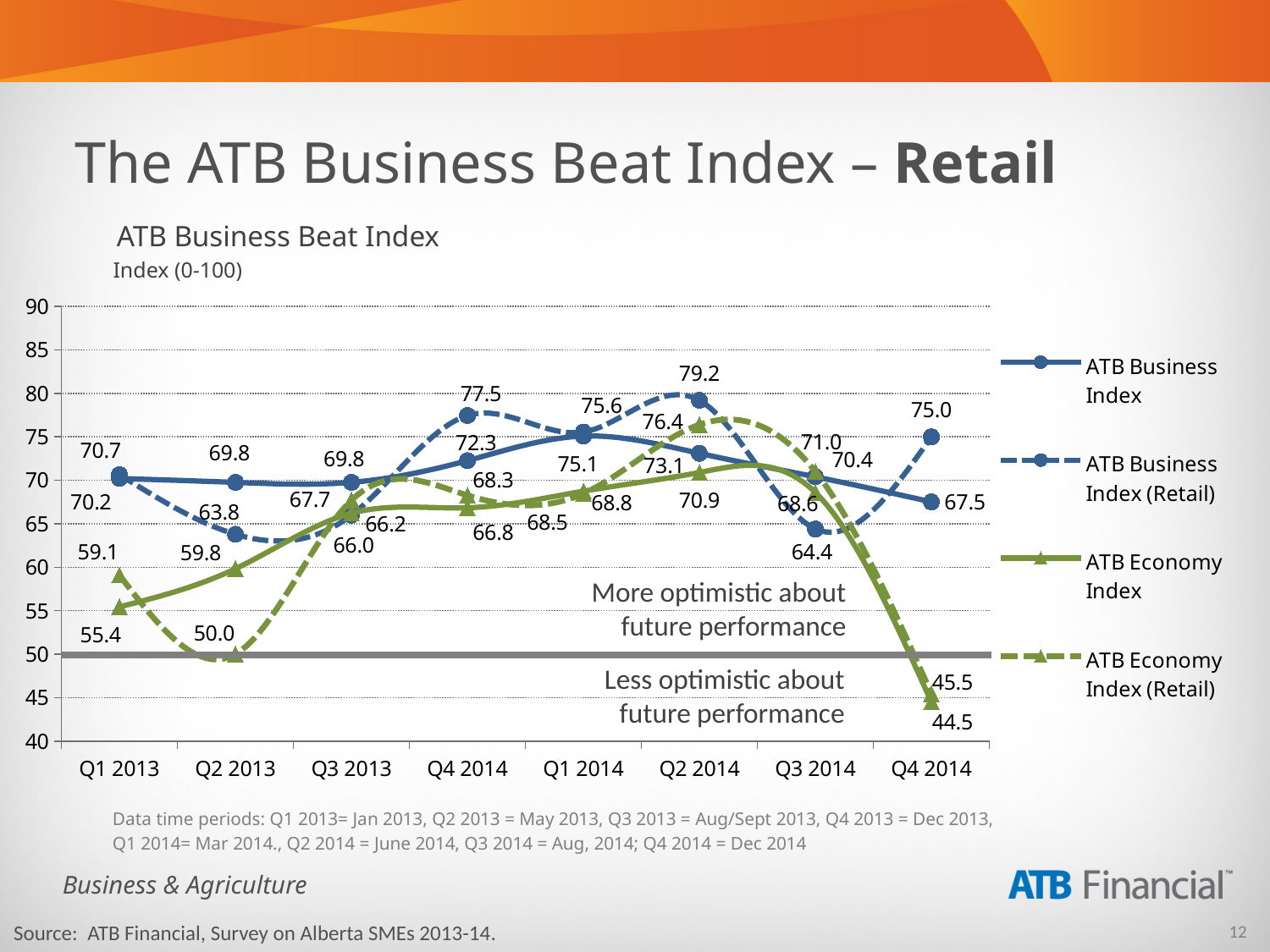
What is the value of the ATB Business Index in Q1 2013? 70.2 What is the value of the ATB Economy Index (Retail) in Q2 2013? 50.0 What is the difference between the ATB Business Index (70.7) and the ATB Business Index (Retail) (70.2) in Q1 2013? 0.5 In which period is the ATB Economy Index (Retail) at its lowest value? Q4 2014 Is the value of the ATB Economy Index (Retail) in Q4 2014 greater or less than 50? less How many series does the legend list? 4 What is the value of the ATB Business Index (Retail) in Q2 2013? 63.8 In which period does the ATB Business Index (Retail) reach its highest value? Q2 2014 In Q2 2013, which is larger: the ATB Business Index or the ATB Business Index (Retail)? ATB Business Index What is the value of the ATB Business Index (Retail) in Q2 2014? 79.2 How many time periods are plotted along the x axis? 8 What type of chart is shown on the slide? Line chart